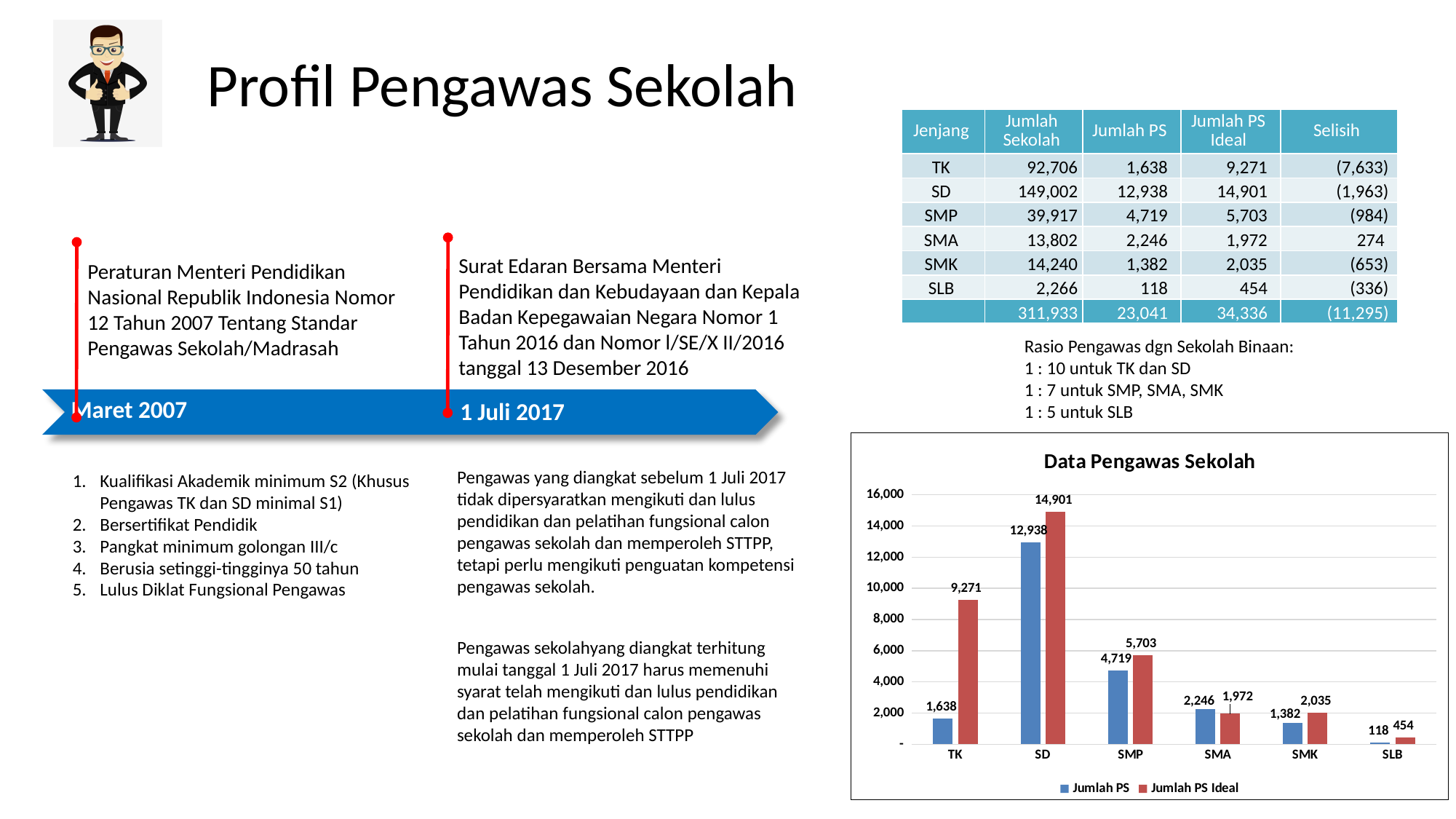
How many series does the chart legend list? 2 What is the Jumlah PS Ideal value for TK in the chart? 9,271 Which category has the lowest Jumlah PS value in the chart? SLB What is the title of the chart on the slide? Data Pengawas Sekolah What is the difference between Jumlah PS Ideal and Jumlah PS for SMK in the chart? 653 Is the Jumlah PS value for SD greater or less than 12,000? greater What is the difference between Jumlah PS Ideal and Jumlah PS for SD in the chart? 1,963 For SMA, which is larger in the chart: Jumlah PS or Jumlah PS Ideal? Jumlah PS What type of chart is shown on the slide? bar chart Which category has the highest Jumlah PS Ideal value in the chart? SD What is the Jumlah PS value for SMP in the chart? 4,719 How many categories are shown on the x axis of the chart? 6